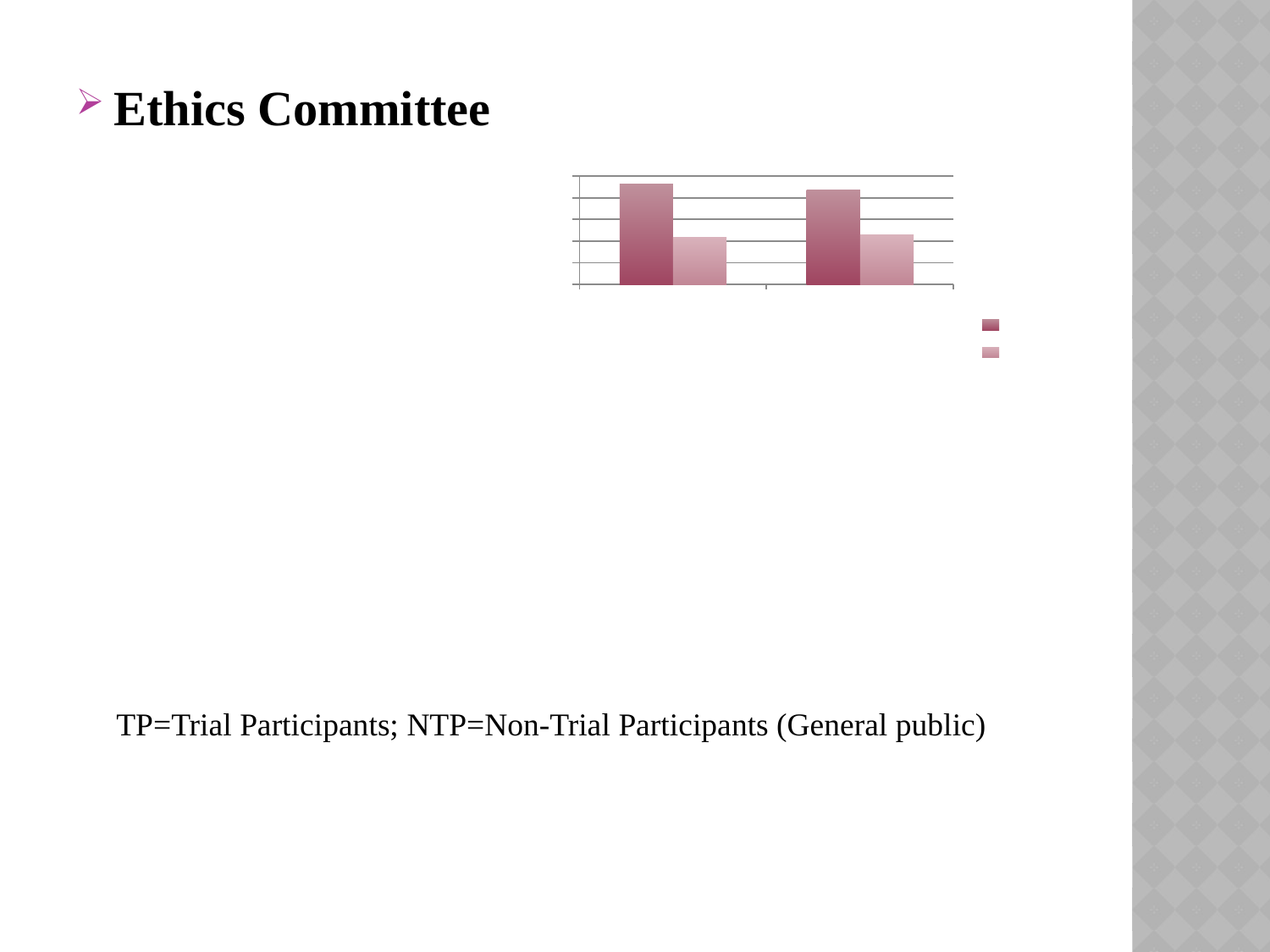
Which bar is the tallest in the chart: the darker bar of the left group or the darker bar of the right group? the darker bar of the left group How many bars are plotted in total in the chart? 4 How many series does the legend list? 2 In the left group of bars, is the darker bar taller or shorter than the lighter bar? taller How many groups of bars are plotted in the chart? 2 In the right group of bars, is the darker bar taller or shorter than the lighter bar? taller What kind of chart is shown on the slide? bar chart Are the bars in the chart vertical or horizontal? vertical